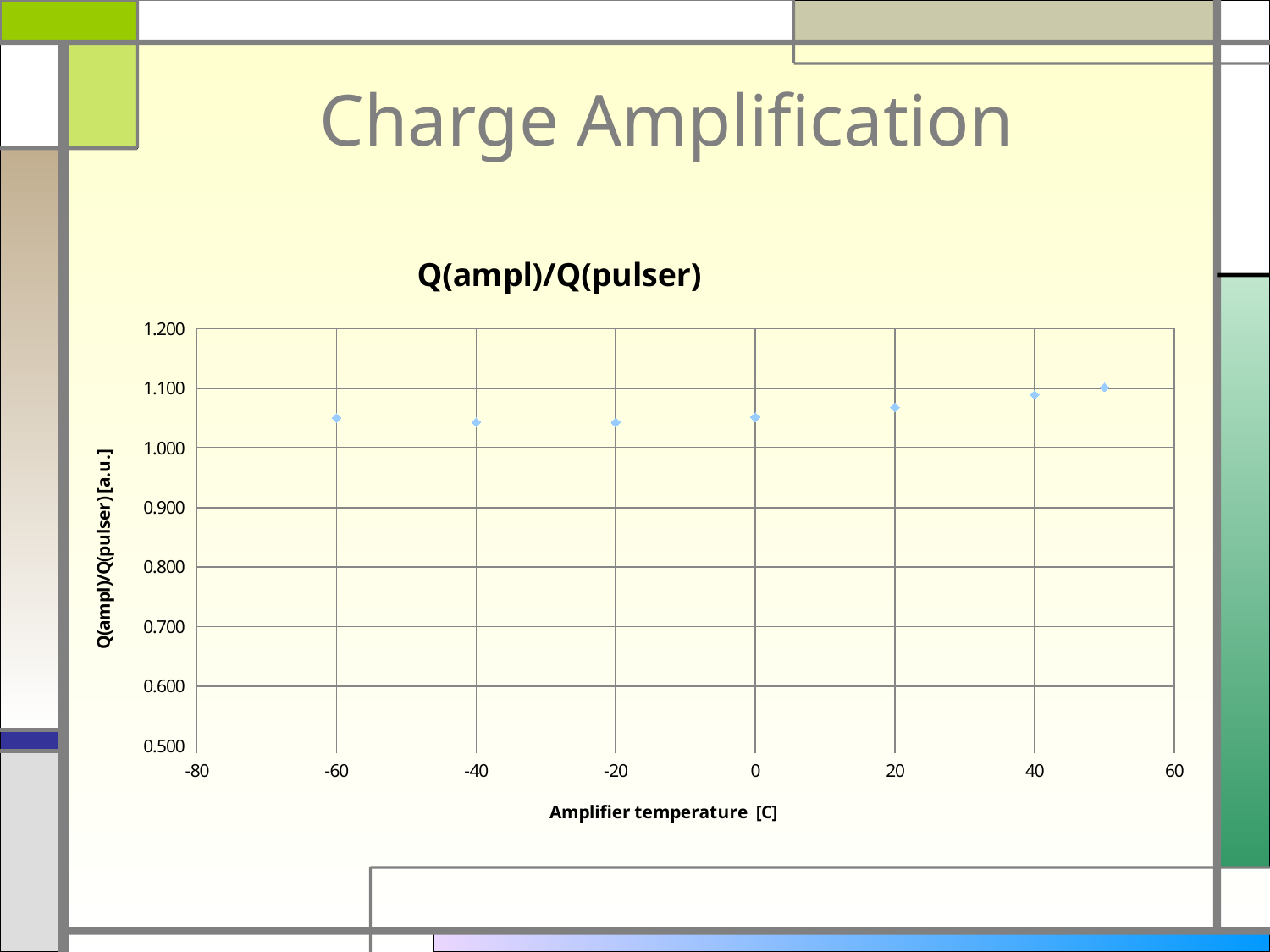
Is the value at an amplifier temperature of -60 greater or less than 1.000? greater Do the plotted values generally rise or fall as the amplifier temperature increases from -60 to 50? rise What kind of chart is shown on the slide? scatter chart What is the label of the x axis of the chart? Amplifier temperature [C] How many data points are plotted on the chart? 7 Which is larger: the value at an amplifier temperature of 40 or the value at -20? 40 Is the value at an amplifier temperature of 0 greater or less than 1.200? less Which is larger: the value at an amplifier temperature of 20 or the value at -60? 20 Is the value at an amplifier temperature of -40 greater or less than 0.900? greater At which amplifier temperature is the plotted value highest? 50 What is the title of the chart? Q(ampl)/Q(pulser)